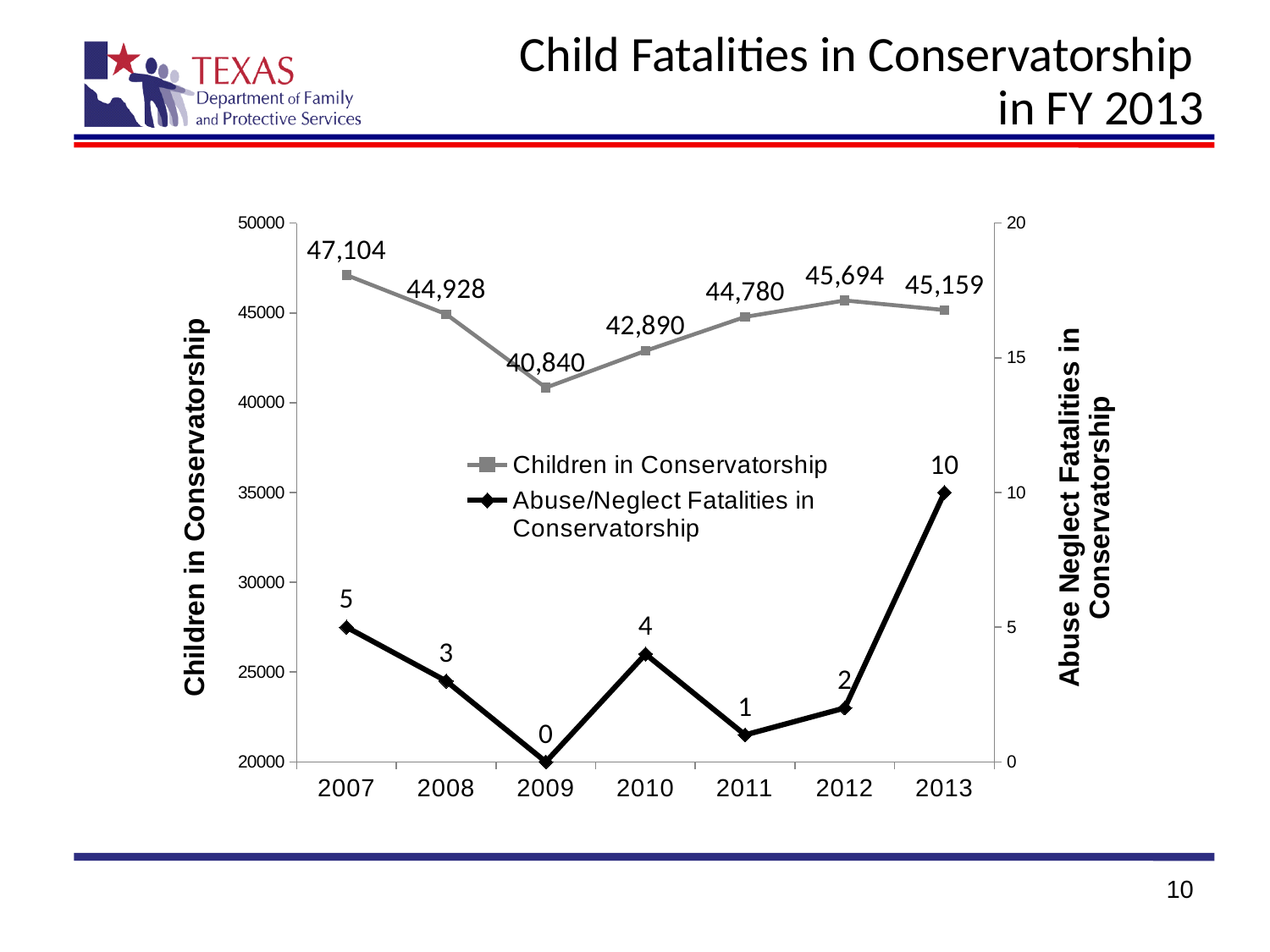
How many years are plotted along the x axis? 7 What was the number of Children in Conservatorship in 2009? 40,840 What is the difference in Children in Conservatorship between 2012 and 2013? 535 What kind of chart is shown on the slide? line chart How many series does the legend list? 2 In which year was the number of Children in Conservatorship highest? 2007 What is the title of the chart? Child Fatalities in Conservatorship in FY 2013 In which year was the number of Abuse/Neglect Fatalities in Conservatorship lowest? 2009 How did the number of Abuse/Neglect Fatalities in Conservatorship change from 2012 to 2013? rose Which year had more Abuse/Neglect Fatalities in Conservatorship, 2008 or 2010? 2010 Is the number of Children in Conservatorship in 2011 greater or less than 45000? less How many Abuse/Neglect Fatalities in Conservatorship were there in 2013? 10